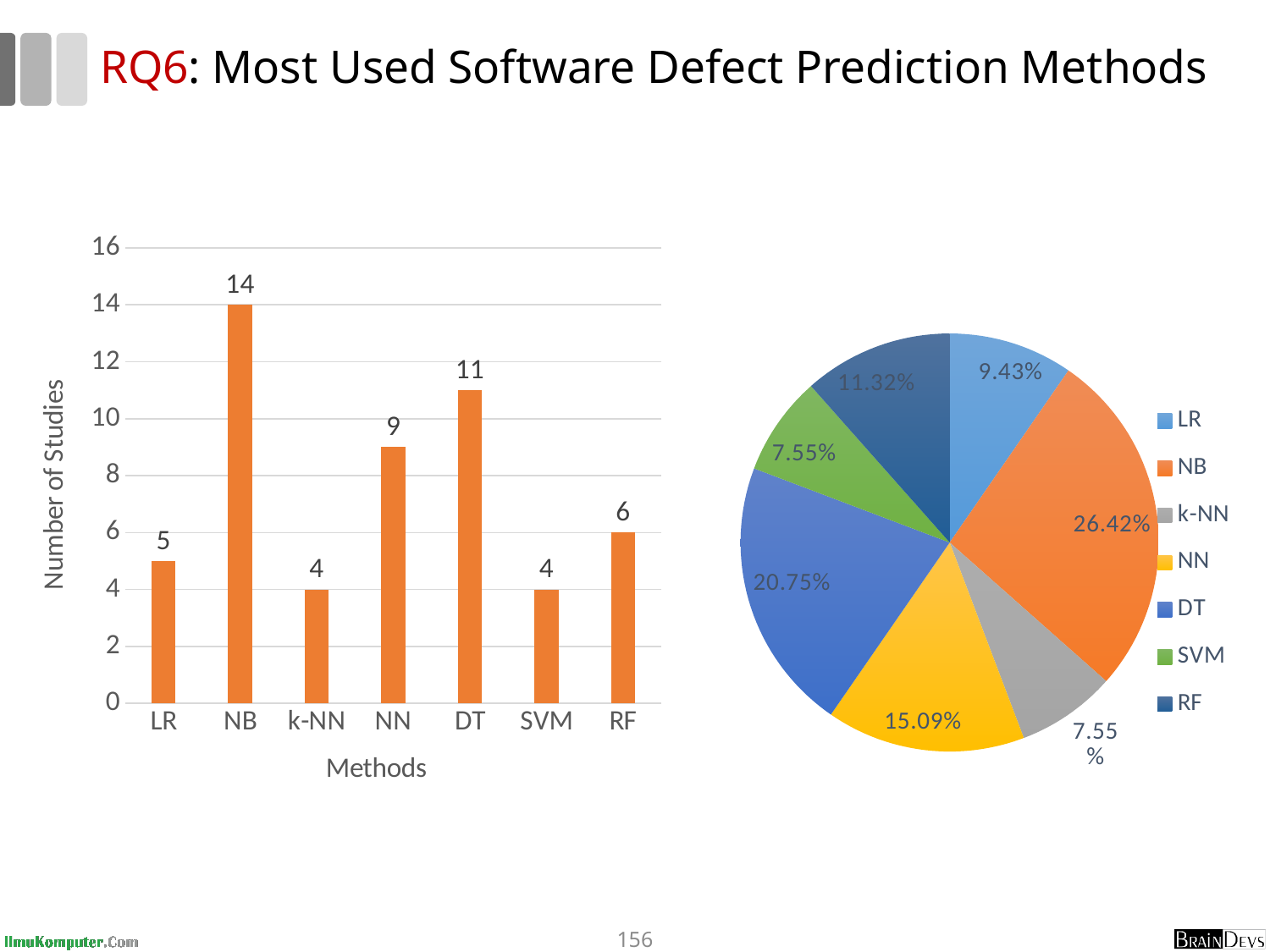
What kind of chart is the chart on the left? bar chart In the pie chart on the right, what share does DT have? 20.75% In the bar chart on the left, how many studies used NB? 14 In the bar chart on the left, which has more studies, NN or RF? NN In the bar chart on the left, what is the difference in number of studies between NB and DT? 3 In the pie chart on the right, what share does NB have? 26.42% In the bar chart on the left, which method has the highest number of studies? NB In the bar chart on the left, what is the label of the y axis? Number of Studies In the pie chart on the right, how many entries does the legend list? 7 In the pie chart on the right, which method has the largest slice? NB In the bar chart on the left, how many studies used DT? 11 In the bar chart on the left, how many methods are shown on the x axis? 7